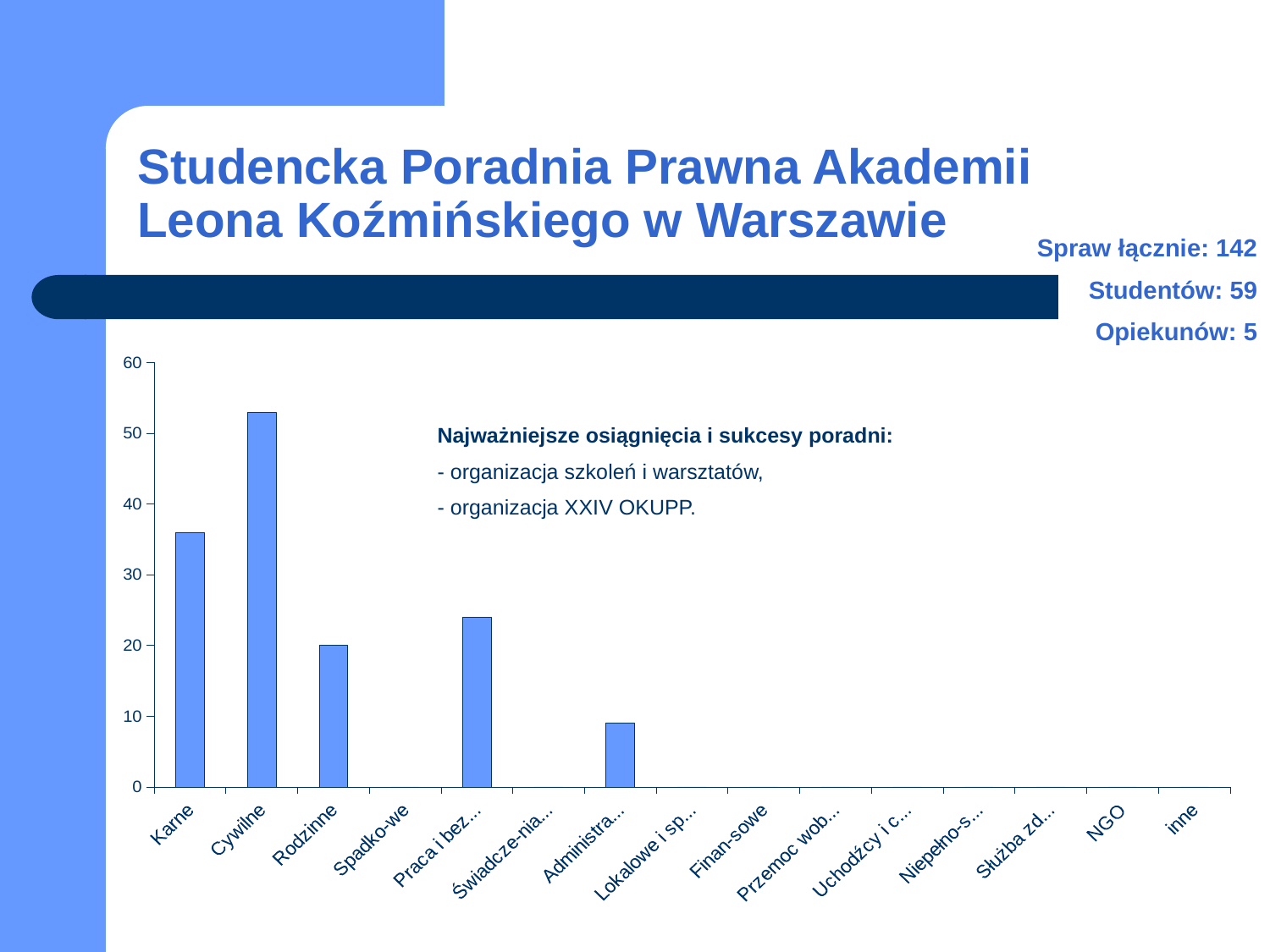
Which is larger, the value for Karne or the value for Rodzinne? Karne Is the value for Praca i bez... greater or less than 20? greater What is the highest value shown on the y axis of the chart? 60 What kind of chart is shown on the slide? bar chart Is the value for Karne greater or less than 30? greater What is the value for Rodzinne in the chart? 20 Is the value for Cywilne greater or less than 50? greater Which category has the highest bar in the chart? Cywilne Which is larger, the value for Praca i bez... or the value for Administra...? Praca i bez... How many categories are shown on the x axis of the chart? 15